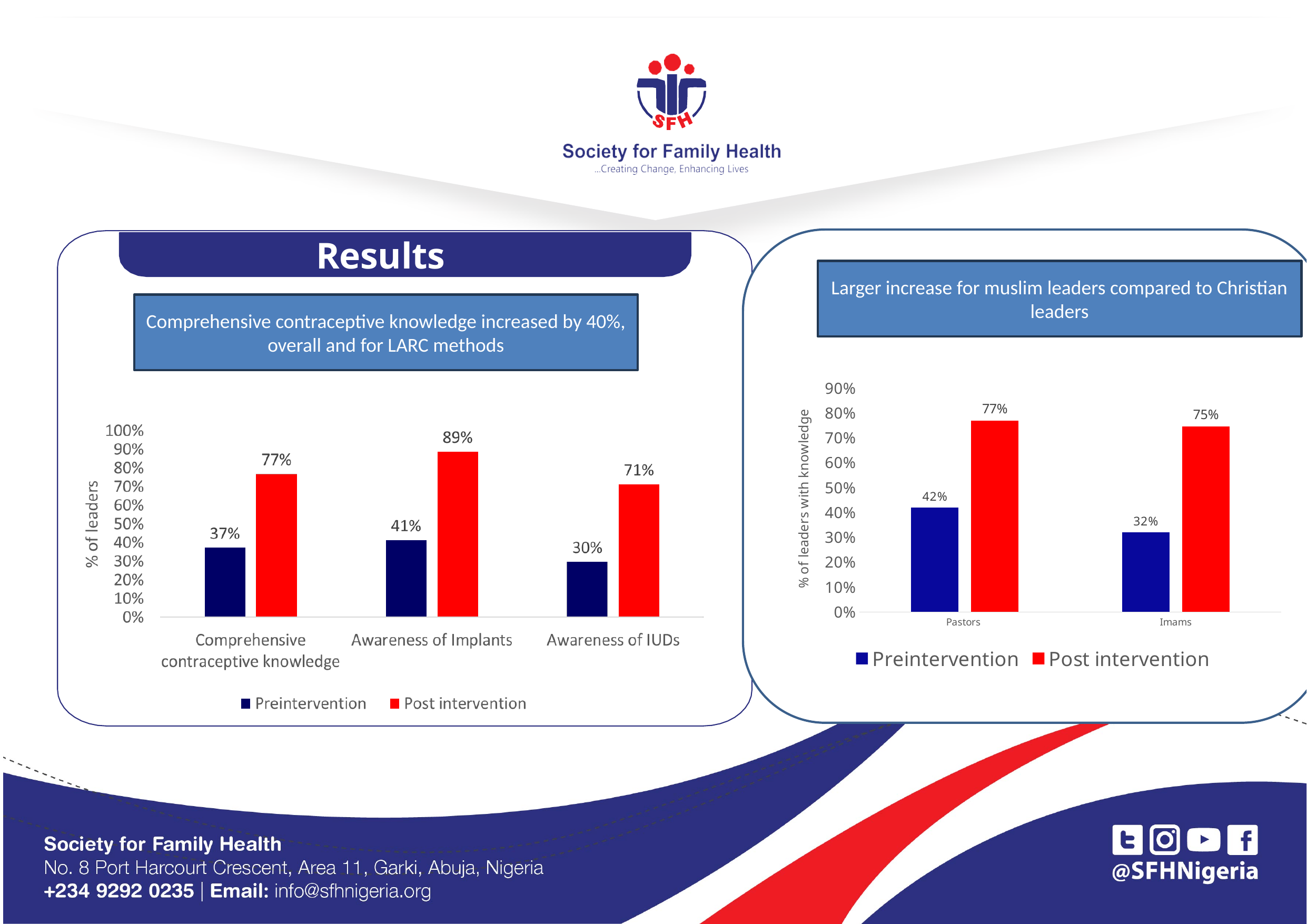
In the left chart, how many categories are shown on the x axis? 3 In the right chart, what is the Preintervention value for Imams? 32% In the left chart, what is the Post intervention value for Awareness of IUDs? 71% In the left chart, how many series does the legend list? 2 In the left chart, what is the Post intervention value for Awareness of Implants? 89% In the right chart, what is the Post intervention value for Pastors? 77% In the right chart, what is the difference between the Post intervention and Preintervention values for Imams? 43% What kind of chart is the right chart? Bar chart In the right chart, which is larger: the Preintervention value for Pastors or for Imams? Pastors In the left chart, what is the difference between the Post intervention and Preintervention values for Comprehensive contraceptive knowledge? 40% In the left chart, which category has the lowest Preintervention value? Awareness of IUDs In the left chart, what is the Preintervention value for Comprehensive contraceptive knowledge? 37%